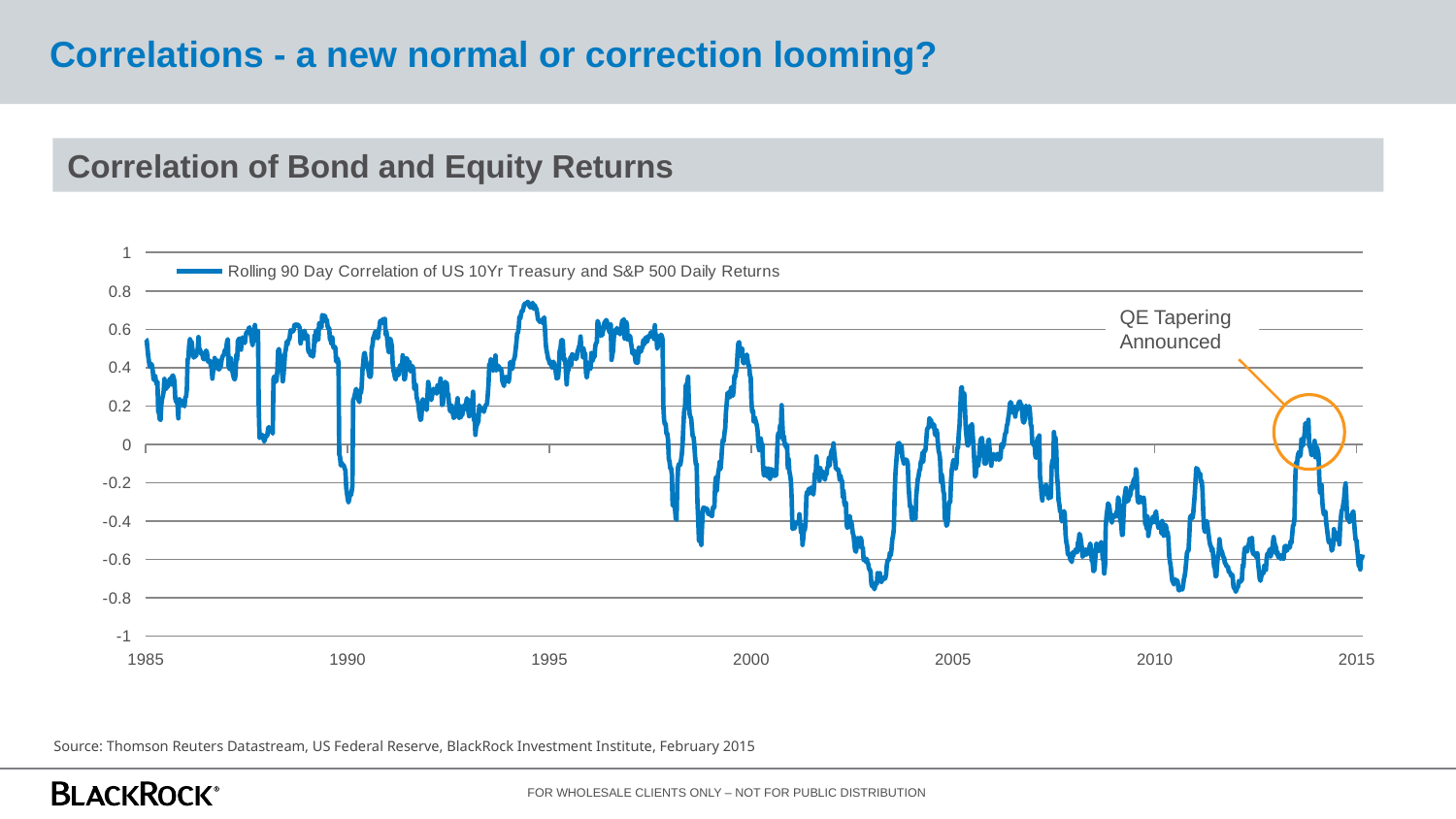
What kind of chart is shown on the slide? line chart What series name appears in the chart legend? Rolling 90 Day Correlation of US 10Yr Treasury and S&P 500 Daily Returns Is the correlation value at the start of 1985 greater or less than 0? greater Which is larger, the correlation value around 1995 or the correlation value around 2003? around 1995 Is the correlation value around 2012 greater or less than -0.2? less Overall, does the correlation rise or fall from 1985 to 2015? fall What is the highest value shown on the y axis? 1 How many series does the legend list? 1 What is the title of the chart? Correlation of Bond and Equity Returns How many year labels are shown on the x axis? 7 Is the correlation value around 2003 greater or less than -0.4? less